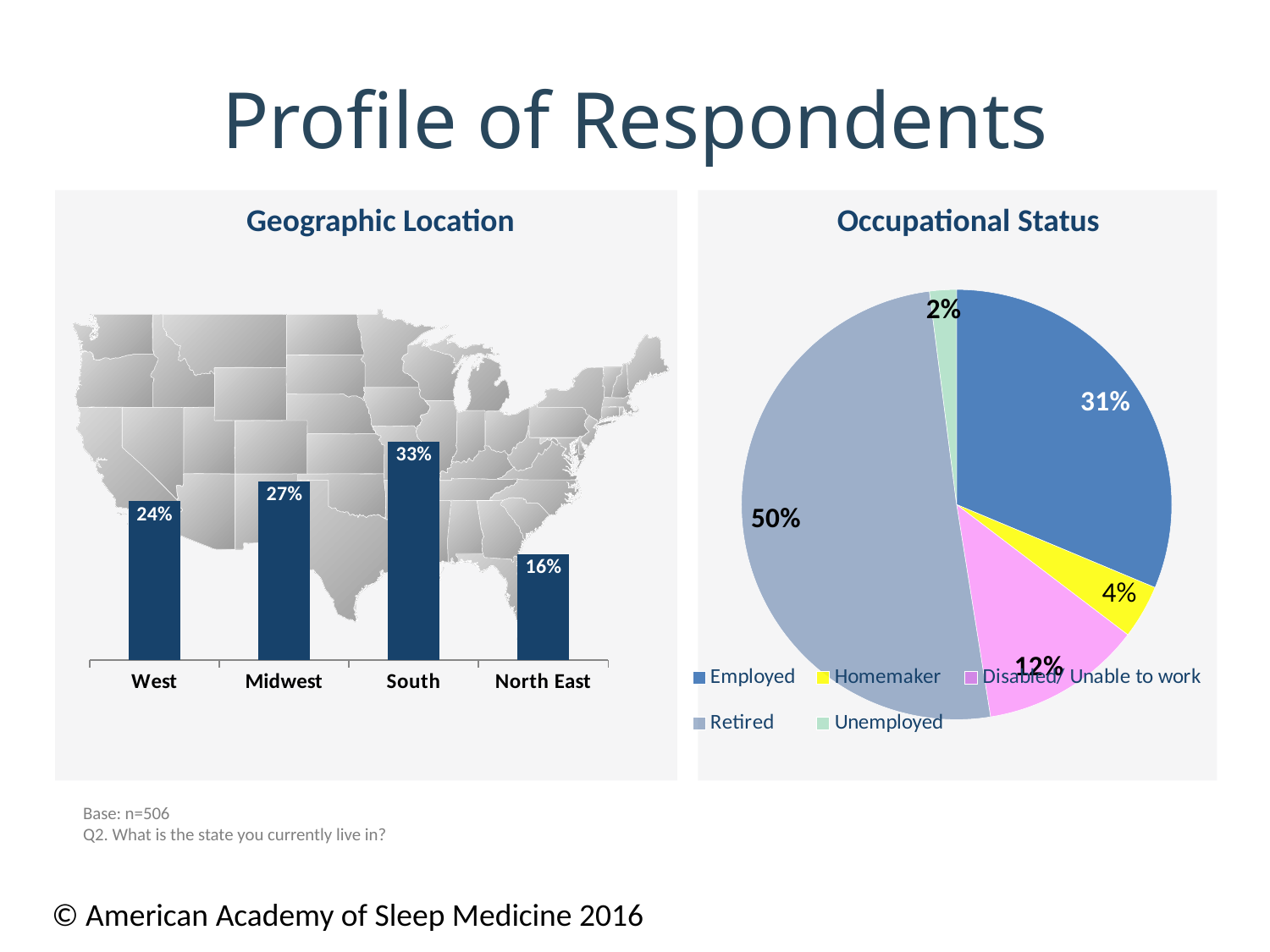
In the Geographic Location chart, which region has the lowest value? North East In the Occupational Status chart, what share of respondents are Retired? 50% How many regions are shown in the Geographic Location chart? 4 In the Geographic Location chart, what is the value for the South? 33% In the Geographic Location chart, which region has the highest value? South In the Geographic Location chart, what is the value for the Midwest? 27% In the Occupational Status chart, which category has the smallest slice? Unemployed In the Occupational Status chart, what share of respondents are Employed? 31% In the Geographic Location chart, what is the difference between the South and the North East? 17% How many categories does the legend of the Occupational Status chart list? 5 What kind of chart is the Geographic Location chart? Bar chart In the Geographic Location chart, which is larger, West or Midwest? Midwest